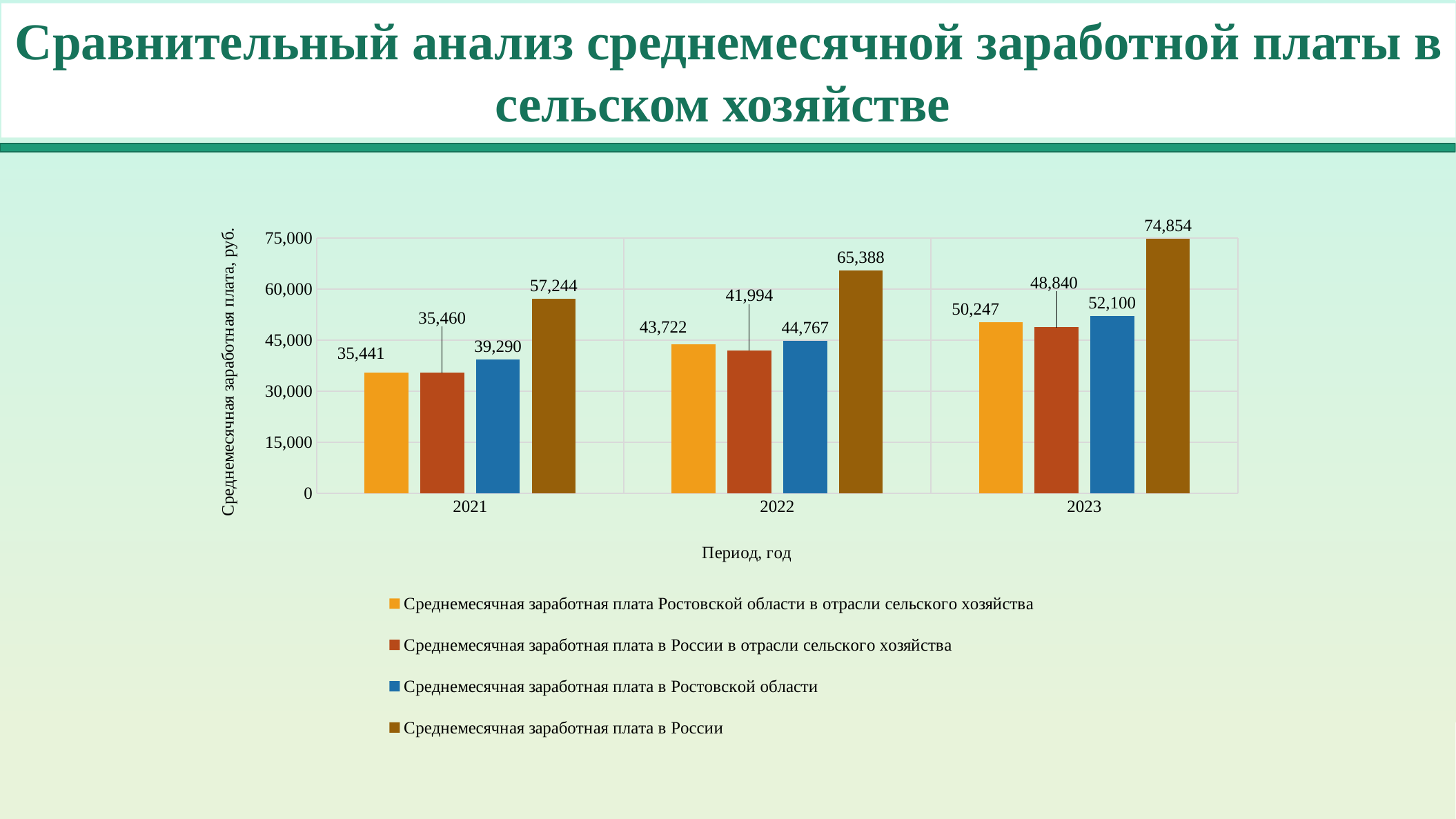
What type of chart is shown on the slide? bar chart How many series does the legend list? 4 Does the average monthly wage in Russia rise or fall from 2021 to 2023? rise What is the average monthly wage in Russia (Среднемесячная заработная плата в России) in 2023? 74,854 Which series has the lowest value in 2023? Среднемесячная заработная плата в России в отрасли сельского хозяйства What is the difference between the average monthly wage in Russia and the average monthly wage in the Rostov region in 2023? 22,754 What is the average monthly wage in the Rostov region agriculture sector (Среднемесячная заработная плата Ростовской области в отрасли сельского хозяйства) in 2021? 35,441 What is the average monthly wage in Russia's agriculture sector (Среднемесячная заработная плата в России в отрасли сельского хозяйства) in 2022? 41,994 How many years are shown on the x axis? 3 Which is larger in 2022: the average monthly wage in the Rostov region agriculture sector or the average monthly wage in Russia's agriculture sector? Среднемесячная заработная плата Ростовской области в отрасли сельского хозяйства What is the average monthly wage in the Rostov region (Среднемесячная заработная плата в Ростовской области) in 2023? 52,100 Which series has the highest value in 2022? Среднемесячная заработная плата в России